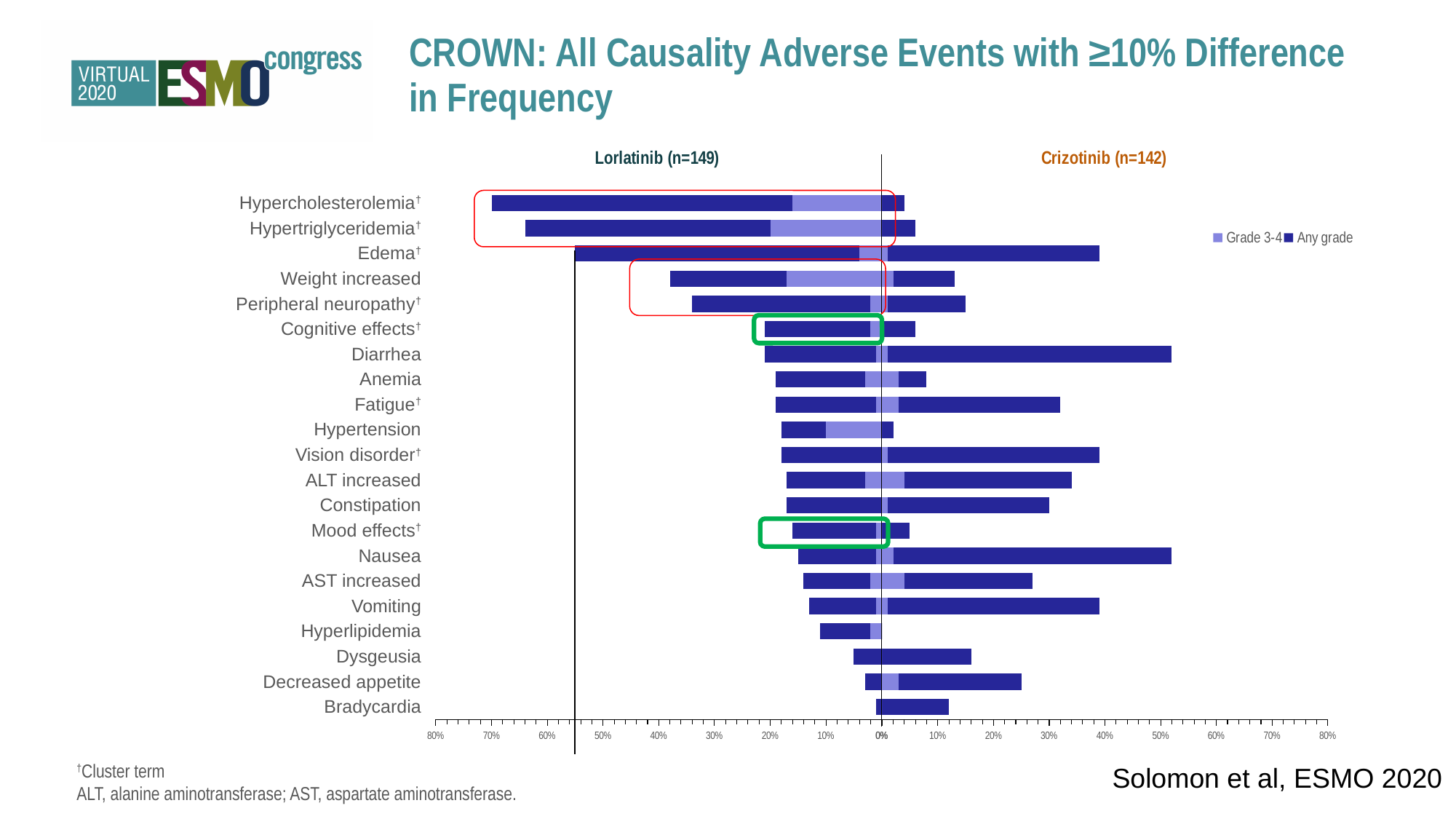
What is the sample size shown for the Crizotinib arm? n=142 Is the any-grade frequency of Hypercholesterolemia in the Lorlatinib arm greater or less than 60%? greater Which adverse event has the lowest any-grade frequency in the Lorlatinib arm? Bradycardia Is the any-grade frequency of Diarrhea in the Crizotinib arm greater or less than 40%? greater Which adverse event has the highest any-grade frequency in the Lorlatinib arm? Hypercholesterolemia How many adverse event categories are listed on the chart? 21 What kind of chart is shown on the slide? Bar chart Is the any-grade frequency of Edema in the Crizotinib arm greater or less than 30%? greater How many series does the legend list? 2 For Diarrhea, which arm has the higher any-grade frequency, Lorlatinib or Crizotinib? Crizotinib For Edema, which arm has the higher any-grade frequency, Lorlatinib or Crizotinib? Lorlatinib